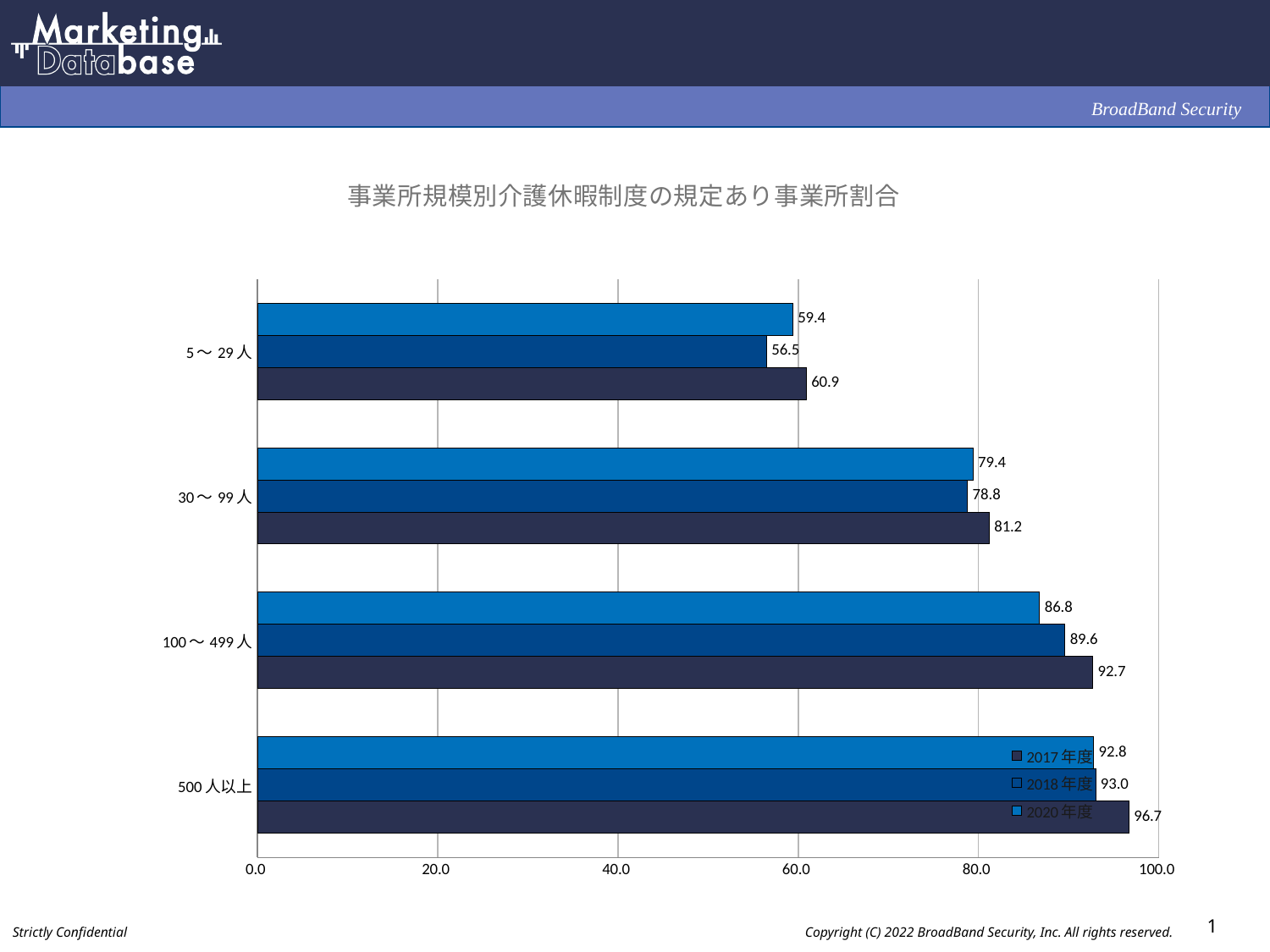
What is the 2020年度 value for 5～29人? 59.4 Which is larger for 30～99人: the 2017年度 value or the 2018年度 value? 2017年度 Which category has the lowest 2018年度 value? 5～29人 How many establishment-size categories are shown on the chart? 4 What is the title of the chart? 事業所規模別介護休暇制度の規定あり事業所割合 How many series does the legend list? 3 Is the 2020年度 value for 30～99人 greater or less than 80.0? less What kind of chart is shown on the slide? bar chart What is the difference between the 2017年度 and 2020年度 values for 100～499人? 5.9 Which category has the highest 2017年度 value? 500人以上 What is the 2017年度 value for 500人以上? 96.7 What is the 2018年度 value for 100～499人? 89.6